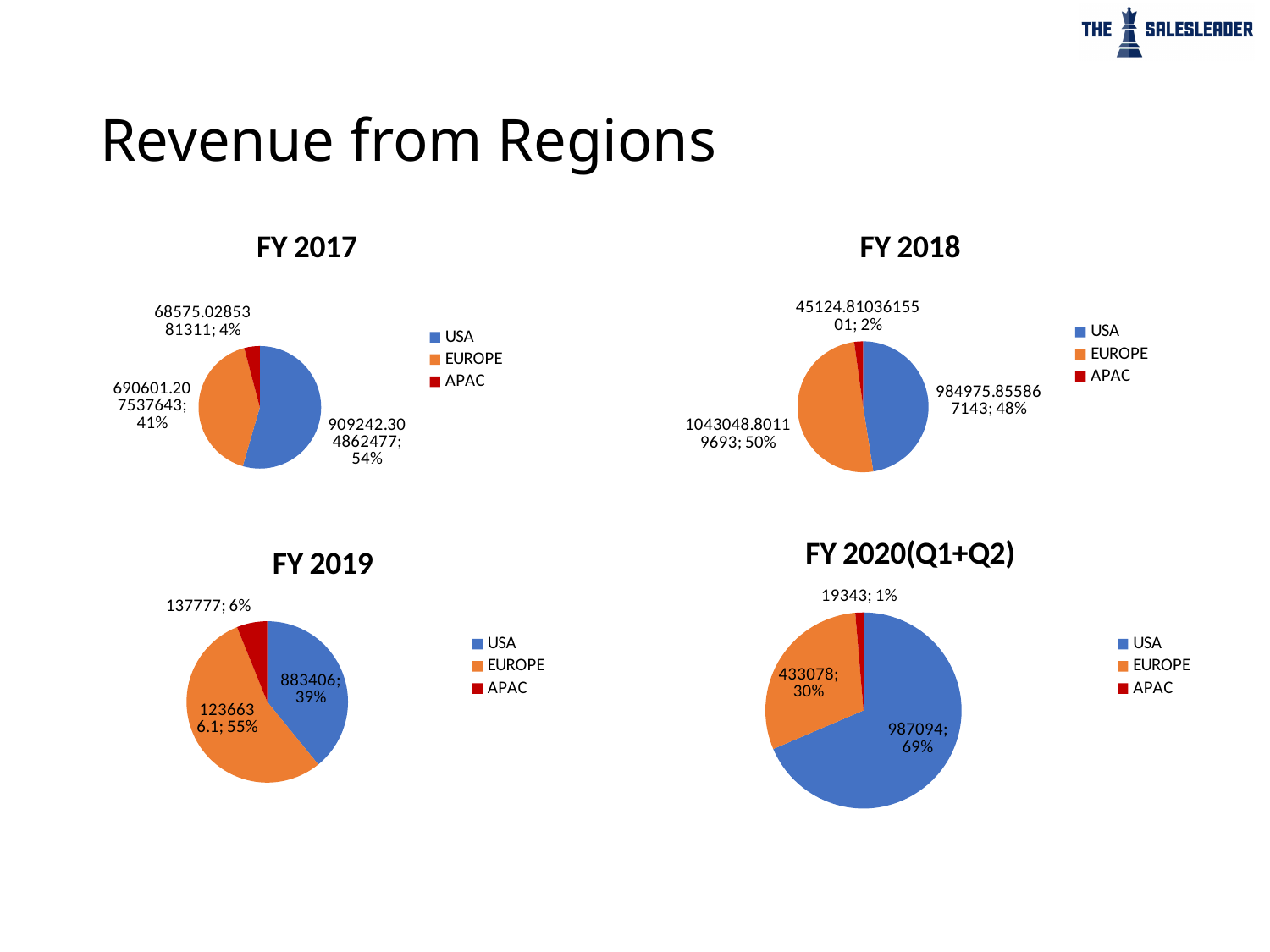
What kind of chart is used for FY 2017? Pie chart In the FY 2018 chart, what share of revenue comes from EUROPE? 50% In the FY 2019 chart, which is larger, the share for USA or the share for EUROPE? EUROPE In the FY 2020(Q1+Q2) chart, what share of revenue comes from the USA? 69% How many slices does the FY 2018 pie chart have? 3 In the FY 2020(Q1+Q2) chart, what is the revenue value for EUROPE? 433078 In the FY 2017 chart, what share of revenue comes from APAC? 4% In the FY 2019 chart, which region has the smallest share of revenue? APAC How many entries does the legend of the FY 2020(Q1+Q2) chart list? 3 In the FY 2020(Q1+Q2) chart, what is the difference between the USA and EUROPE revenue values? 554016 In the FY 2017 chart, which region has the largest share of revenue? USA In the FY 2019 chart, what is the revenue value for APAC? 137777